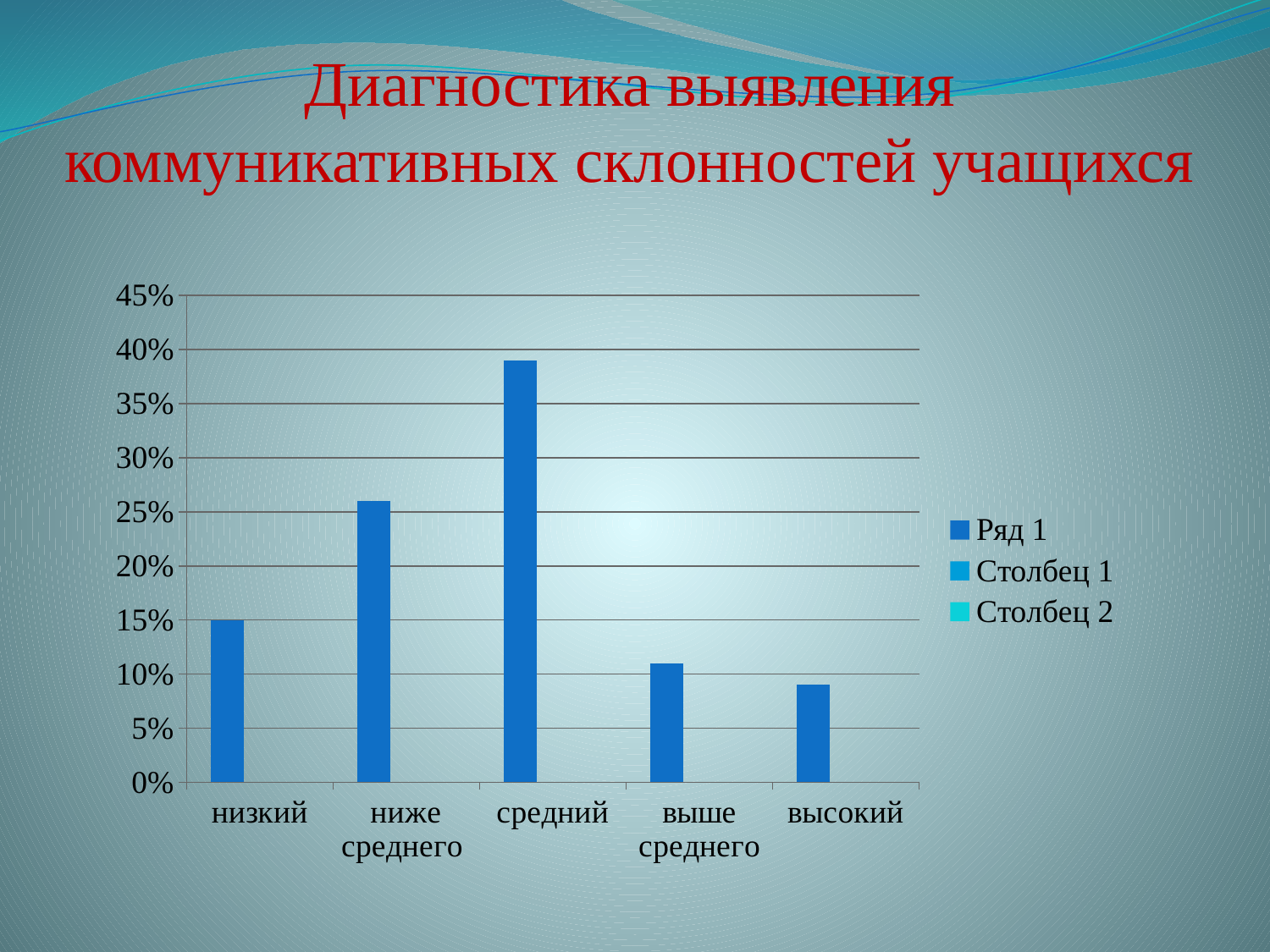
Is the value for низкий greater or less than 20%? less Which category has the lowest bar in the chart? высокий What kind of chart is shown on the slide? bar chart Which is larger, the value for низкий or the value for средний? средний What is the first entry listed in the chart's legend? Ряд 1 Is the value for средний greater or less than 35%? greater How many entries does the chart's legend list? 3 How many categories are shown on the x axis of the chart? 5 Which category has the highest bar in the chart? средний Which is larger, the value for ниже среднего or the value for выше среднего? ниже среднего